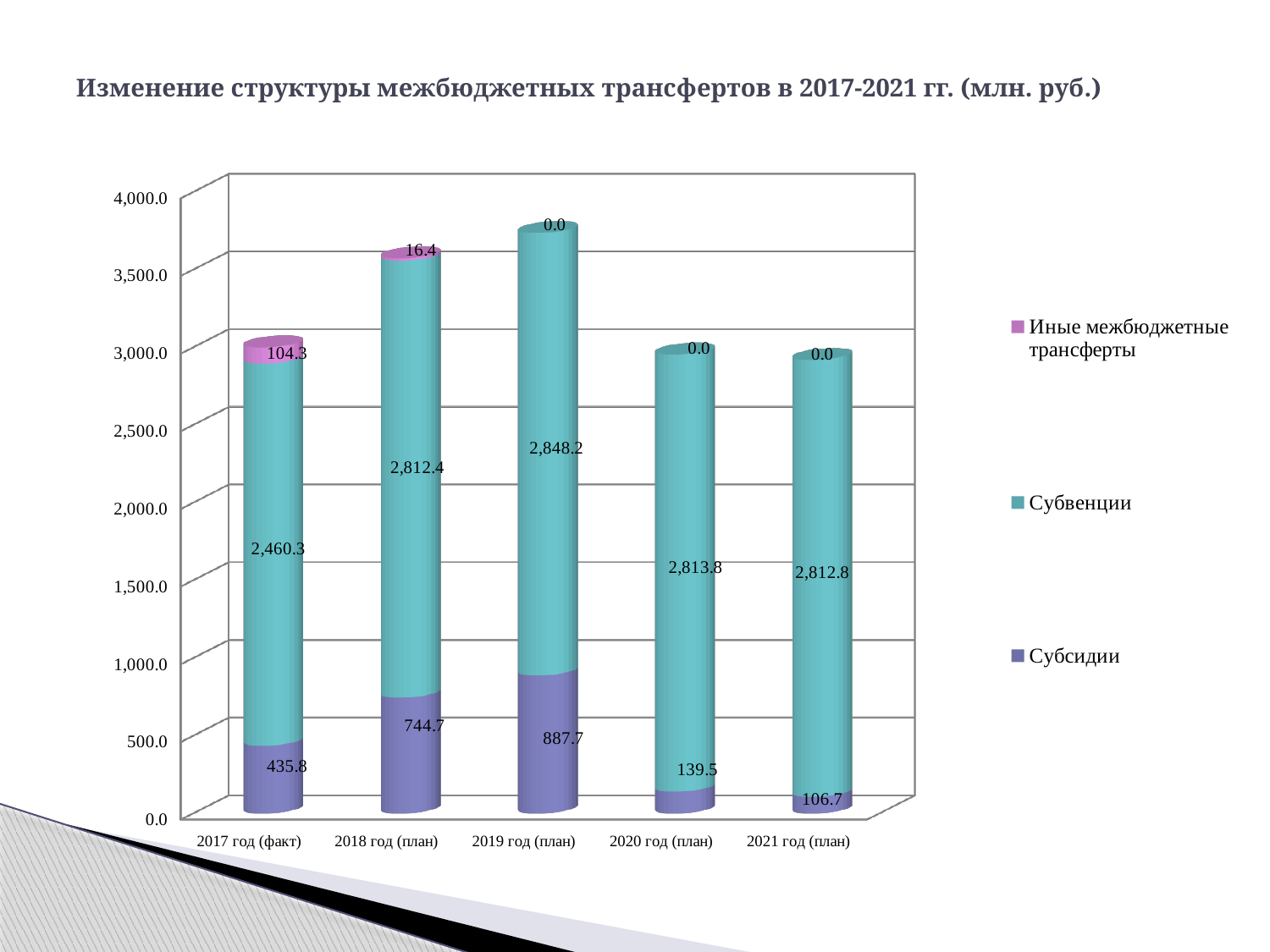
How many series does the legend list? 3 Which is larger: Субсидии for 2020 год (план) or Субсидии for 2021 год (план)? 2020 год (план) In which year is the Субсидии value highest? 2019 год (план) What kind of chart is shown on the slide? Stacked bar chart What is the total of the stacked bar for 2017 год (факт)? 3,000.4 What is the value of Субвенции for 2017 год (факт)? 2,460.3 In which year is the Субвенции value lowest? 2017 год (факт) What is the value of Субсидии for 2019 год (план)? 887.7 What is the difference between the Субсидии values for 2019 год (план) and 2018 год (план)? 143.0 In which year is the Субсидии value lowest? 2021 год (план) How many years (categories) are shown on the x axis? 5 What is the value of Иные межбюджетные трансферты for 2018 год (план)? 16.4